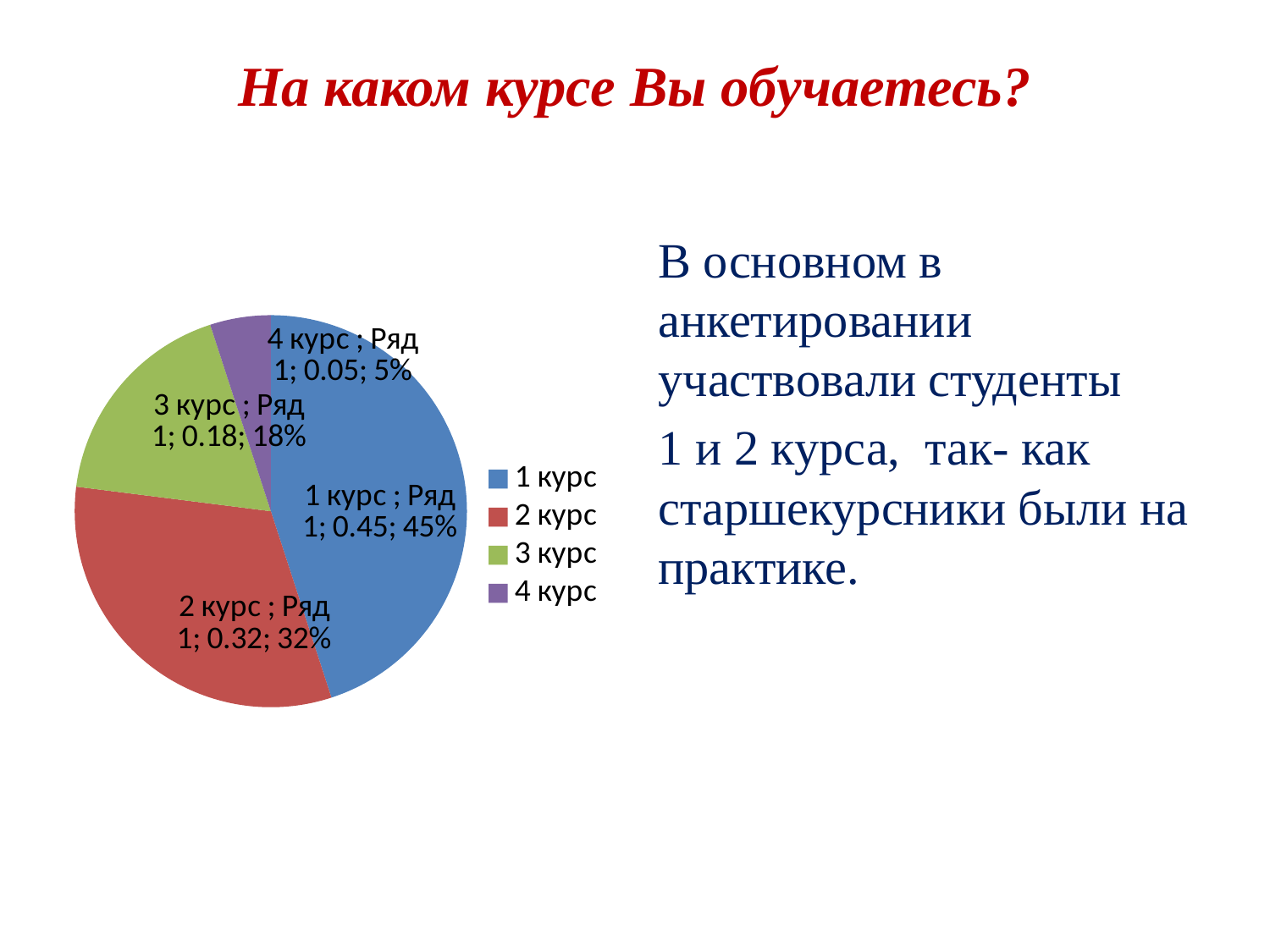
Which slice is larger, 3 курс or 4 курс? 3 курс What is the difference in percentage points between the shares of 1 курс and 2 курс? 13 What colour is the slice for 3 курс? green Which category has the largest slice of the pie? 1 курс What is the value shown for 2 курс as a decimal fraction in its data label? 0.32 How many categories does the pie chart have? 4 What percentage share does the slice for 3 курс have? 18% What percentage share does the slice for 2 курс have? 32% What kind of chart is shown on the slide? pie chart What percentage share does the slice for 4 курс have? 5% Which category has the smallest slice of the pie? 4 курс What percentage share does the slice for 1 курс have? 45%